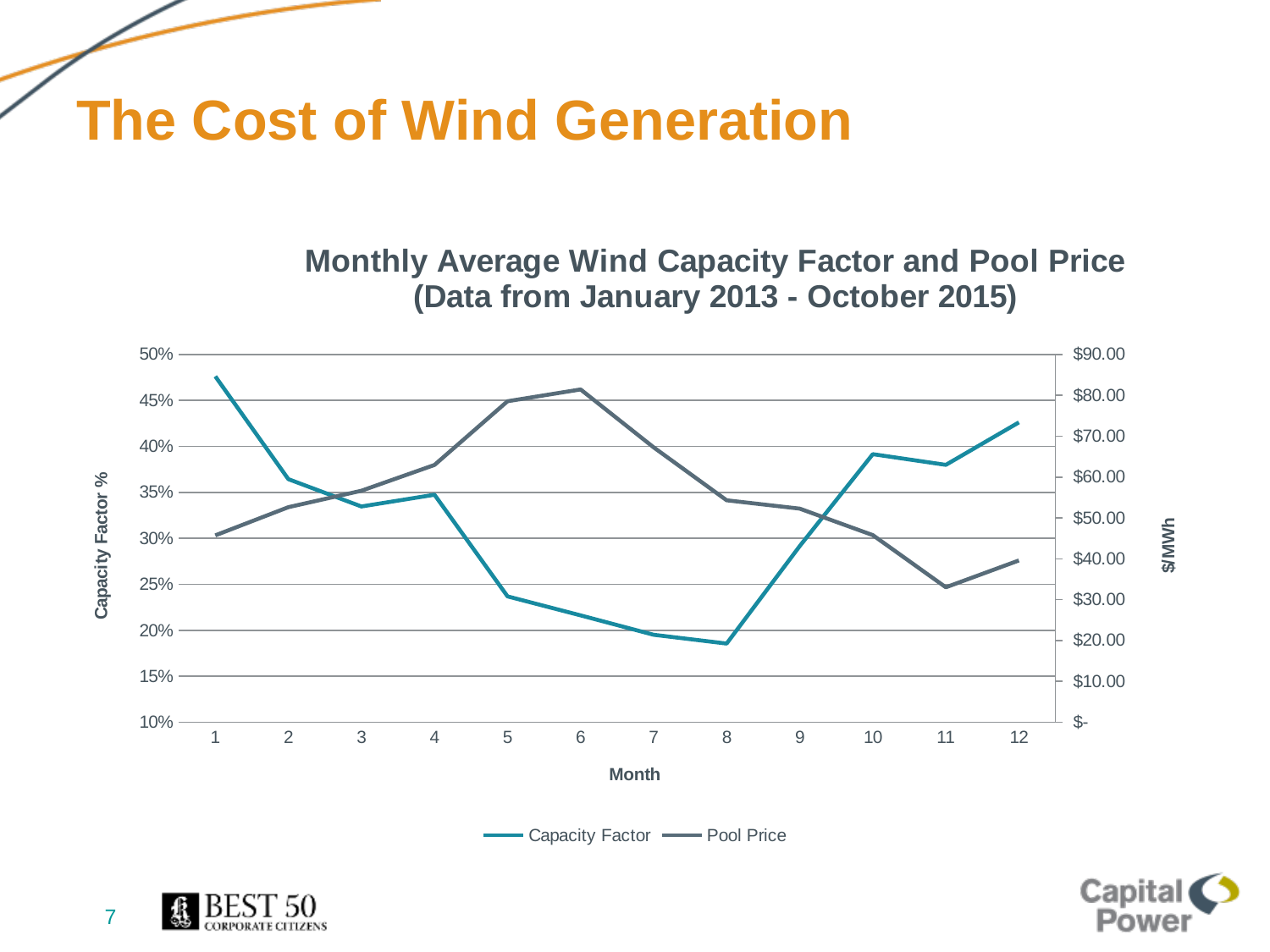
How many months are plotted along the x axis? 12 Which month has the higher Pool Price, month 6 or month 11? 6 How many series does the legend list? 2 In which month is the Pool Price lowest? 11 In which month is the Capacity Factor highest? 1 Is the Capacity Factor for month 1 greater or less than 45%? greater Does the Capacity Factor rise or fall from month 5 to month 8? fall In which month is the Capacity Factor lowest? 8 What kind of chart is shown on the slide? Line chart Is the Capacity Factor for month 8 greater or less than 20%? less What is the label of the right-hand vertical axis? $/MWh Is the Pool Price for month 5 greater or less than $70.00? greater